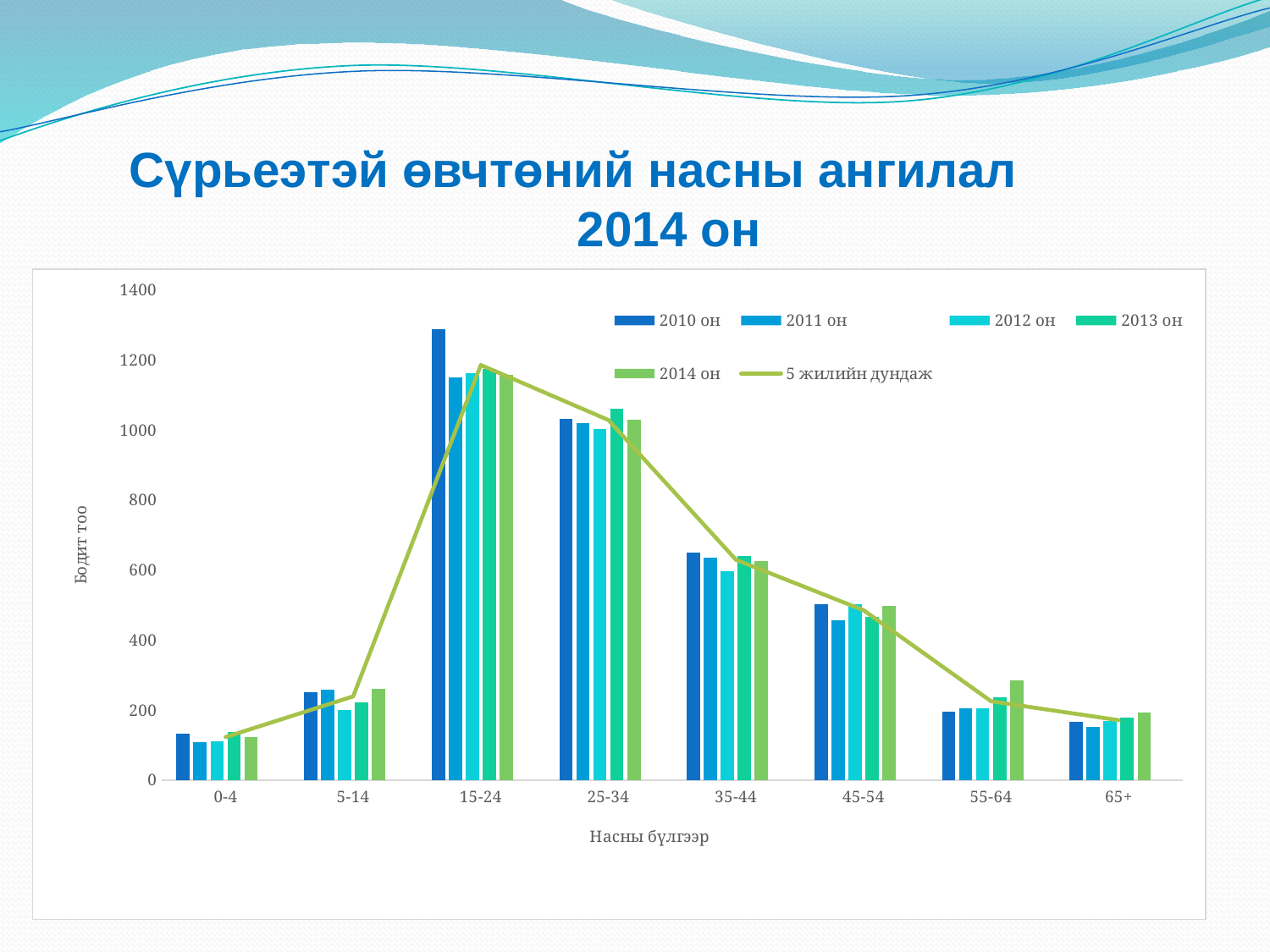
Which age group has the highest value for 2014 он? 15-24 What is the title of the x axis? Насны бүлгээр For the 55-64 age group, which is larger: the 2010 он value or the 2014 он value? 2014 он Which age group has the highest value for 2010 он? 15-24 How many series does the legend list? 6 Is the 2010 он value for the 0-4 age group greater or less than 200? less What kind of chart is shown on the slide? bar and line chart Do the 5 жилийн дундаж line values rise or fall from the 15-24 age group to the 65+ age group? fall How many age groups are shown on the x axis? 8 Is the 2010 он value for the 15-24 age group greater or less than 1200? greater Is the 2014 он value for the 55-64 age group greater or less than 200? greater For the 15-24 age group, which is larger: the 2010 он value or the 2014 он value? 2010 он